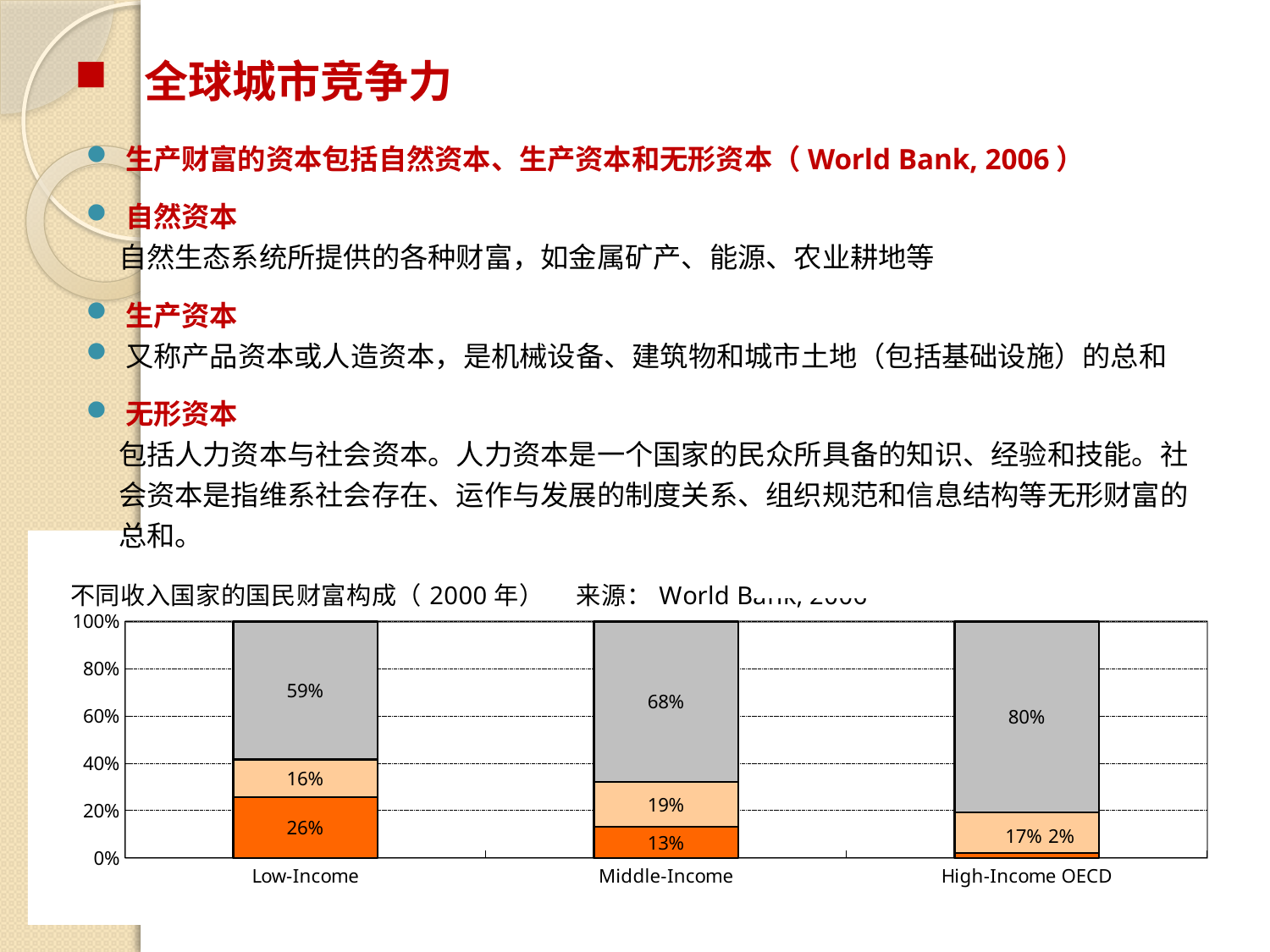
What is the title of the chart? 不同收入国家的国民财富构成（2000年） What is the value of the gray segment for High-Income OECD? 80% Which is larger: the bottom orange segment for Low-Income or for Middle-Income? Low-Income What is the value of the light orange segment for Middle-Income? 19% Which category has the smallest bottom orange segment? High-Income OECD What is the value of the bottom orange segment for Low-Income? 26% What is the value of the gray segment for Middle-Income? 68% Does the gray segment rise or fall moving from Low-Income to High-Income OECD? Rises What is the difference between the gray segment for High-Income OECD and the gray segment for Low-Income? 21 percentage points What kind of chart is shown at the bottom of the slide? Stacked bar chart How many income categories are shown on the x axis of the chart? 3 Which category has the largest gray segment? High-Income OECD